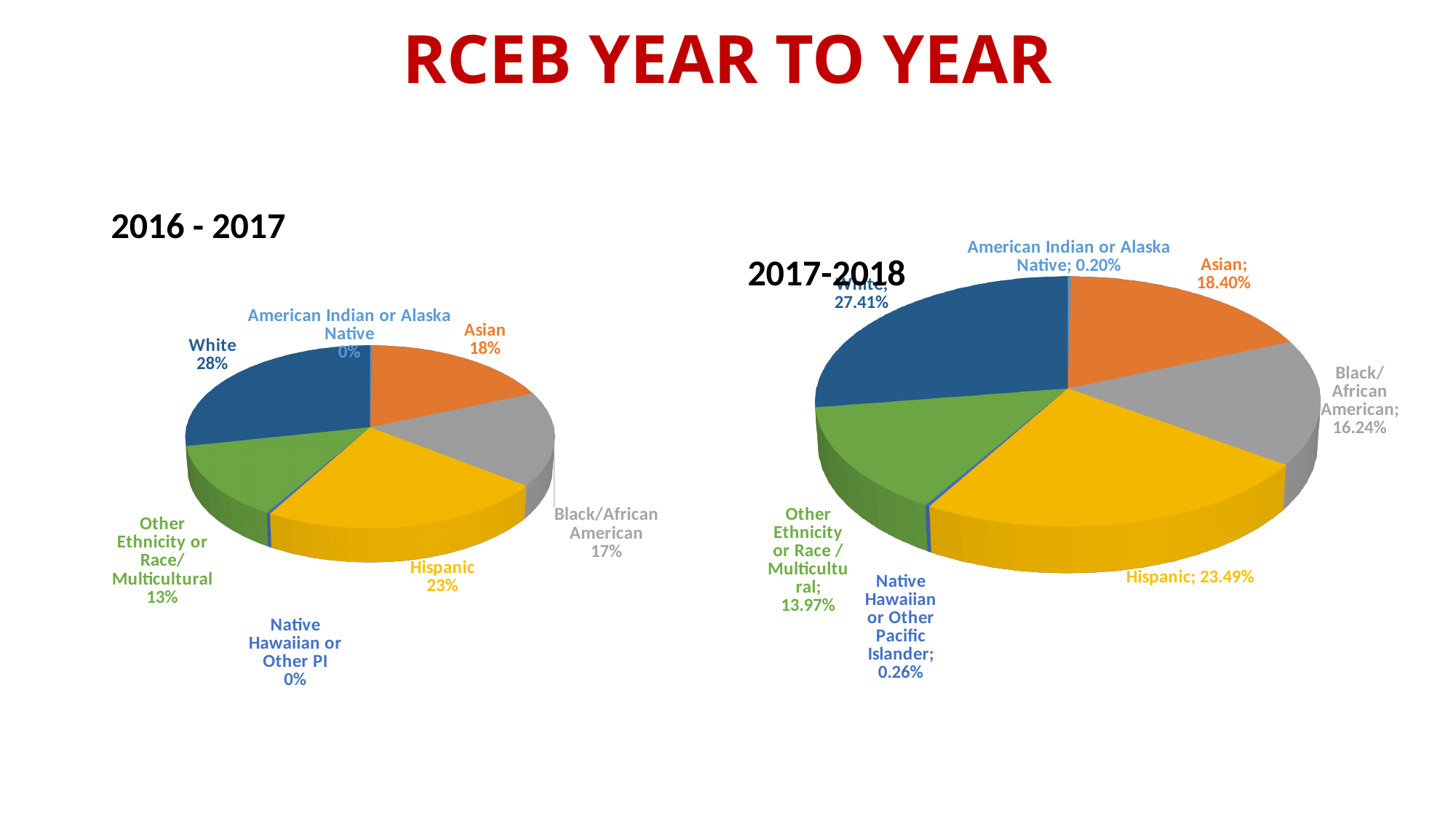
In the 2016 - 2017 chart, what percentage is shown for Hispanic? 23% In the 2017-2018 chart, what percentage is shown for Black/African American? 16.24% What is the title of the slide? RCEB YEAR TO YEAR In the 2017-2018 chart, what percentage is shown for Native Hawaiian or Other Pacific Islander? 0.26% In the 2017-2018 chart, which category has the smallest share? American Indian or Alaska Native How many categories are shown in the 2017-2018 chart? 7 In the 2016 - 2017 chart, what percentage is shown for White? 28% What type of chart is used for the 2016 - 2017 data? Pie chart In the 2016 - 2017 chart, what is the difference between the Asian and Black/African American percentages? 1% In the 2017-2018 chart, which category has the largest share? White In the 2016 - 2017 chart, which category has the largest share? White In the 2017-2018 chart, which is larger, Asian or Black/African American? Asian